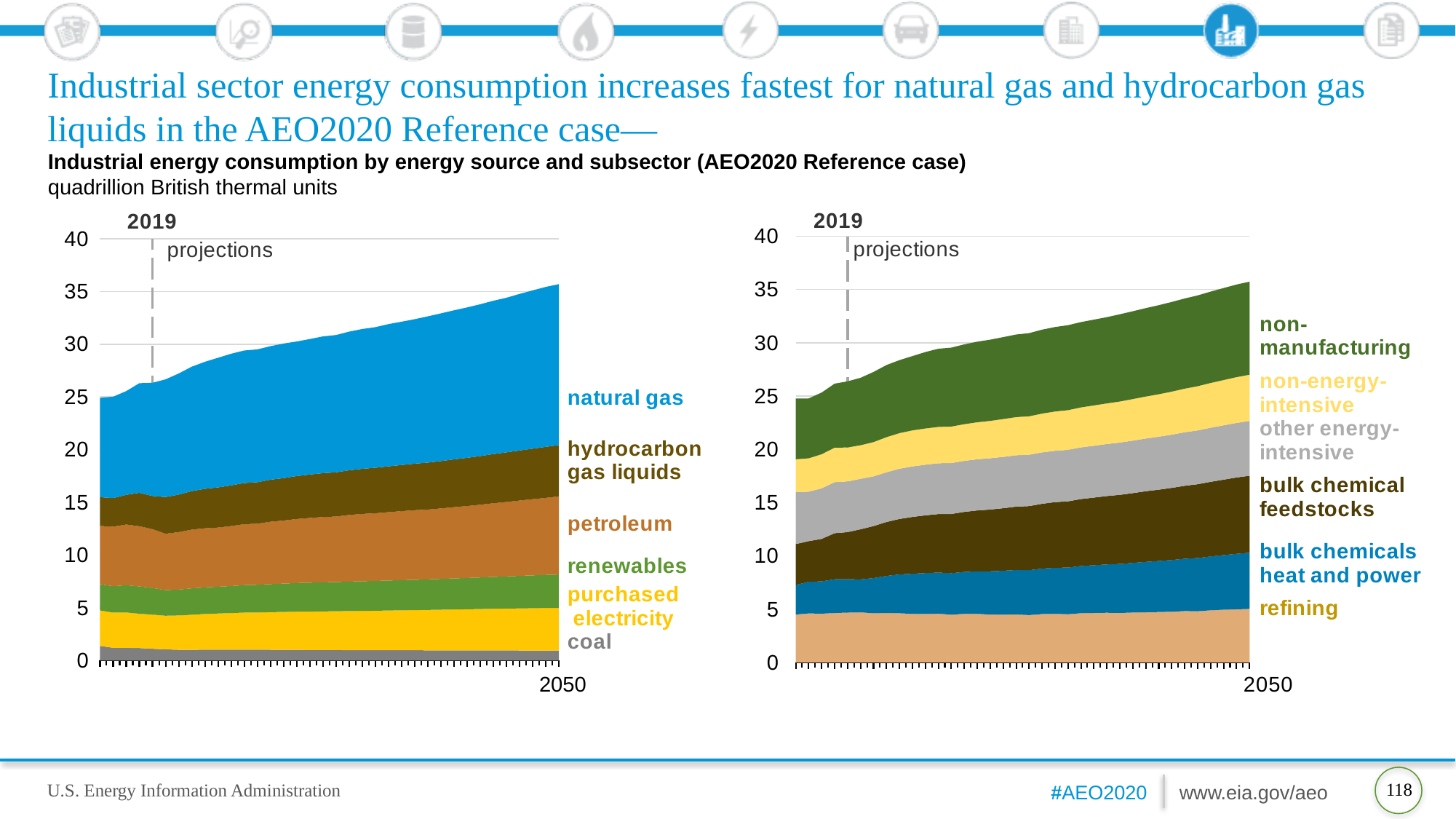
In the left chart, does total industrial energy consumption rise or fall from 2019 to 2050? rise What kind of chart is the left chart on the slide? stacked area chart In the left chart, which is larger in 2050: natural gas consumption or petroleum consumption? natural gas In which year do the projections begin in both charts? 2019 In the left chart, which energy source has the smallest share of industrial energy consumption in 2050? coal In the left chart, which energy source has the largest share of industrial energy consumption in 2050? natural gas In the right chart, which subsector has the largest share of industrial energy consumption in 2050? non-manufacturing In the left chart, is total industrial energy consumption in 2050 greater or less than 35 quadrillion Btu? greater How many energy sources are shown in the left chart? 6 What unit is used for the values in both charts? quadrillion British thermal units How many subsectors are shown in the right chart? 6 In the left chart, is total industrial energy consumption in 2019 greater or less than 30 quadrillion Btu? less